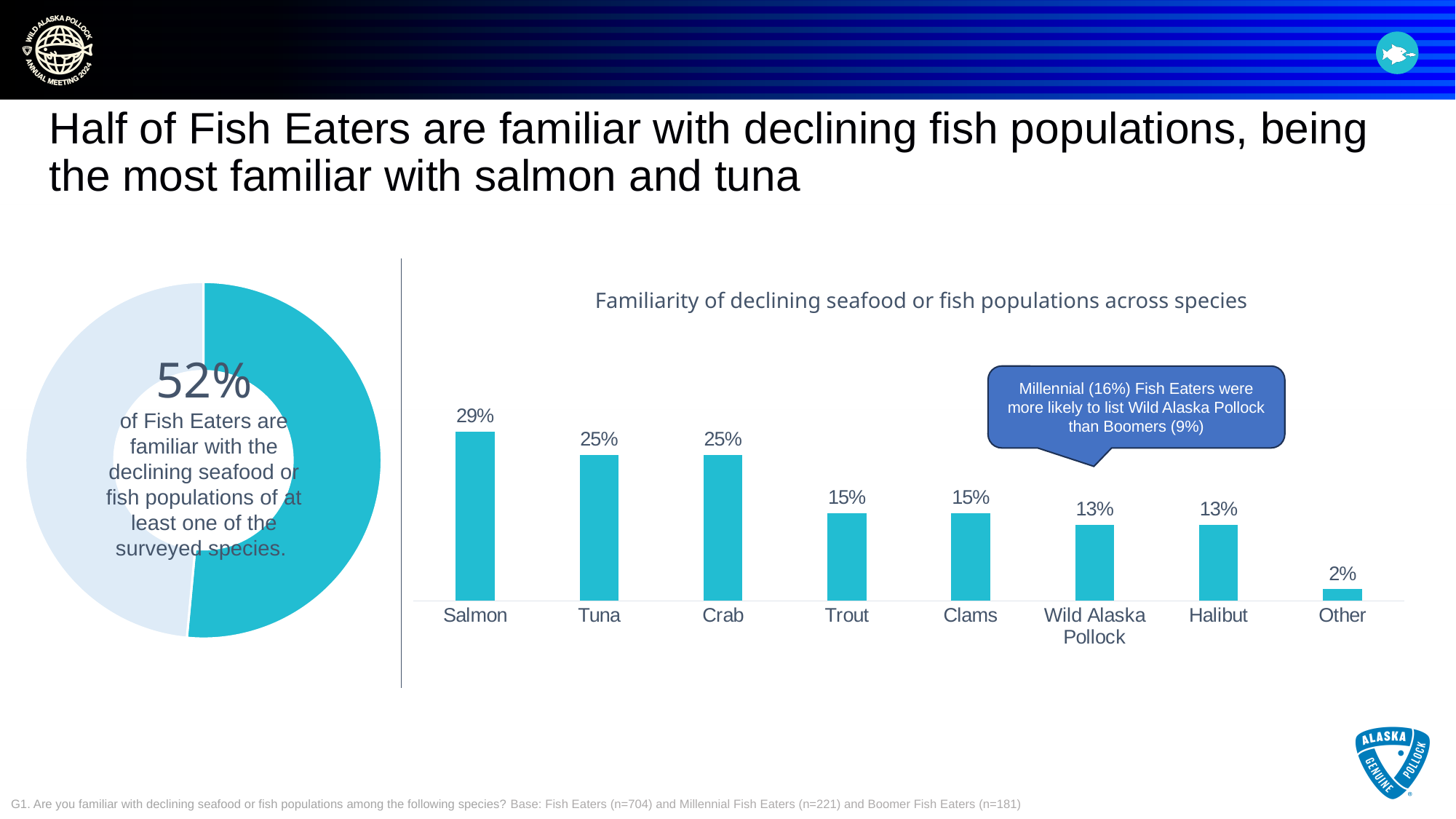
What is the title of the bar chart on the right side of the slide? Familiarity of declining seafood or fish populations across species In the bar chart 'Familiarity of declining seafood or fish populations across species', what is the value for Wild Alaska Pollock? 13% In the bar chart 'Familiarity of declining seafood or fish populations across species', which species has the highest value? Salmon How many categories are shown in the bar chart 'Familiarity of declining seafood or fish populations across species'? 8 In the doughnut chart on the left, what share of Fish Eaters are familiar with declining seafood or fish populations of at least one surveyed species? 52% In the bar chart 'Familiarity of declining seafood or fish populations across species', what is the value for Other? 2% In the bar chart 'Familiarity of declining seafood or fish populations across species', which category has the lowest value? Other In the bar chart 'Familiarity of declining seafood or fish populations across species', what is the difference between the values for Crab and Halibut? 12% In the bar chart 'Familiarity of declining seafood or fish populations across species', which is larger, the value for Trout or the value for Halibut? Trout What kind of chart is the chart on the left side of the slide showing 52%? Doughnut chart In the bar chart 'Familiarity of declining seafood or fish populations across species', what is the value for Salmon? 29% In the bar chart 'Familiarity of declining seafood or fish populations across species', what is the difference between the values for Salmon and Tuna? 4%